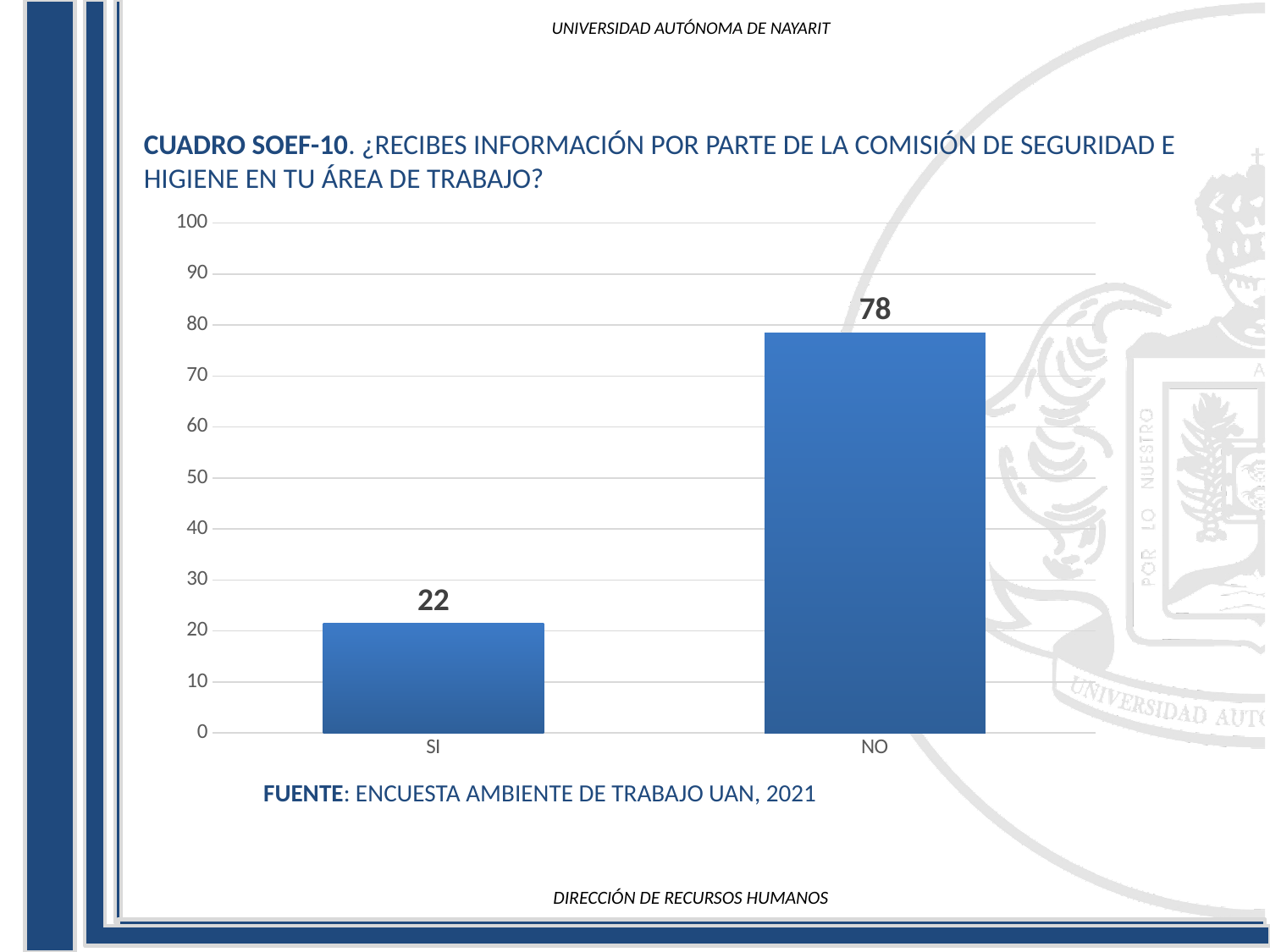
Is the value for NO greater or less than 70? greater What is the maximum value shown on the vertical axis? 100 How many categories are shown on the x axis? 2 What is the difference between the values for NO and SI? 56 Which category has the lowest value? SI What kind of chart is shown on the slide? bar chart Which is larger, the value for SI or the value for NO? NO Which category has the highest value? NO Is the value for SI greater or less than 30? less What source is cited below the chart? ENCUESTA AMBIENTE DE TRABAJO UAN, 2021 What is the value for NO? 78 What is the value for SI? 22